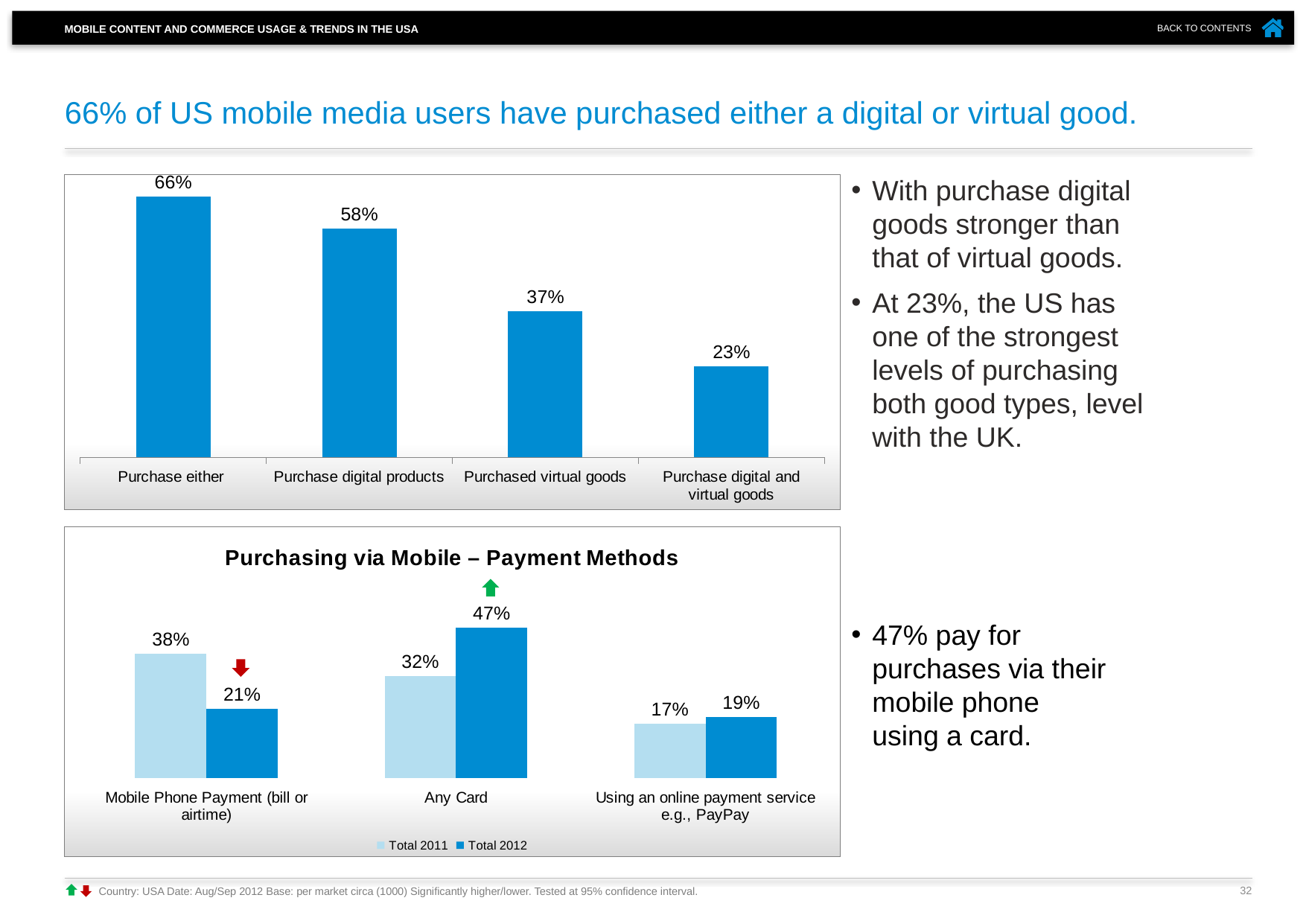
In the top chart, do the values rise or fall from left to right? fall In the top chart, which category has the lowest value? Purchase digital and virtual goods In the chart titled 'Purchasing via Mobile – Payment Methods', what is the difference between Total 2011 and Total 2012 for Mobile Phone Payment (bill or airtime)? 17% In the chart titled 'Purchasing via Mobile – Payment Methods', how many series does the legend list? 2 In the chart titled 'Purchasing via Mobile – Payment Methods', what is the Total 2012 value for Any Card? 47% What kind of chart is the chart titled 'Purchasing via Mobile – Payment Methods'? bar chart In the top chart, what is the difference between Purchase either and Purchased virtual goods? 29% In the chart titled 'Purchasing via Mobile – Payment Methods', what is the Total 2011 value for Mobile Phone Payment (bill or airtime)? 38% In the chart titled 'Purchasing via Mobile – Payment Methods', which category has the highest Total 2012 value? Any Card In the top chart, how many categories are shown? 4 In the chart titled 'Purchasing via Mobile – Payment Methods', which is larger for Using an online payment service e.g., PayPay: Total 2011 or Total 2012? Total 2012 In the top chart, what is the value for Purchase digital products? 58%